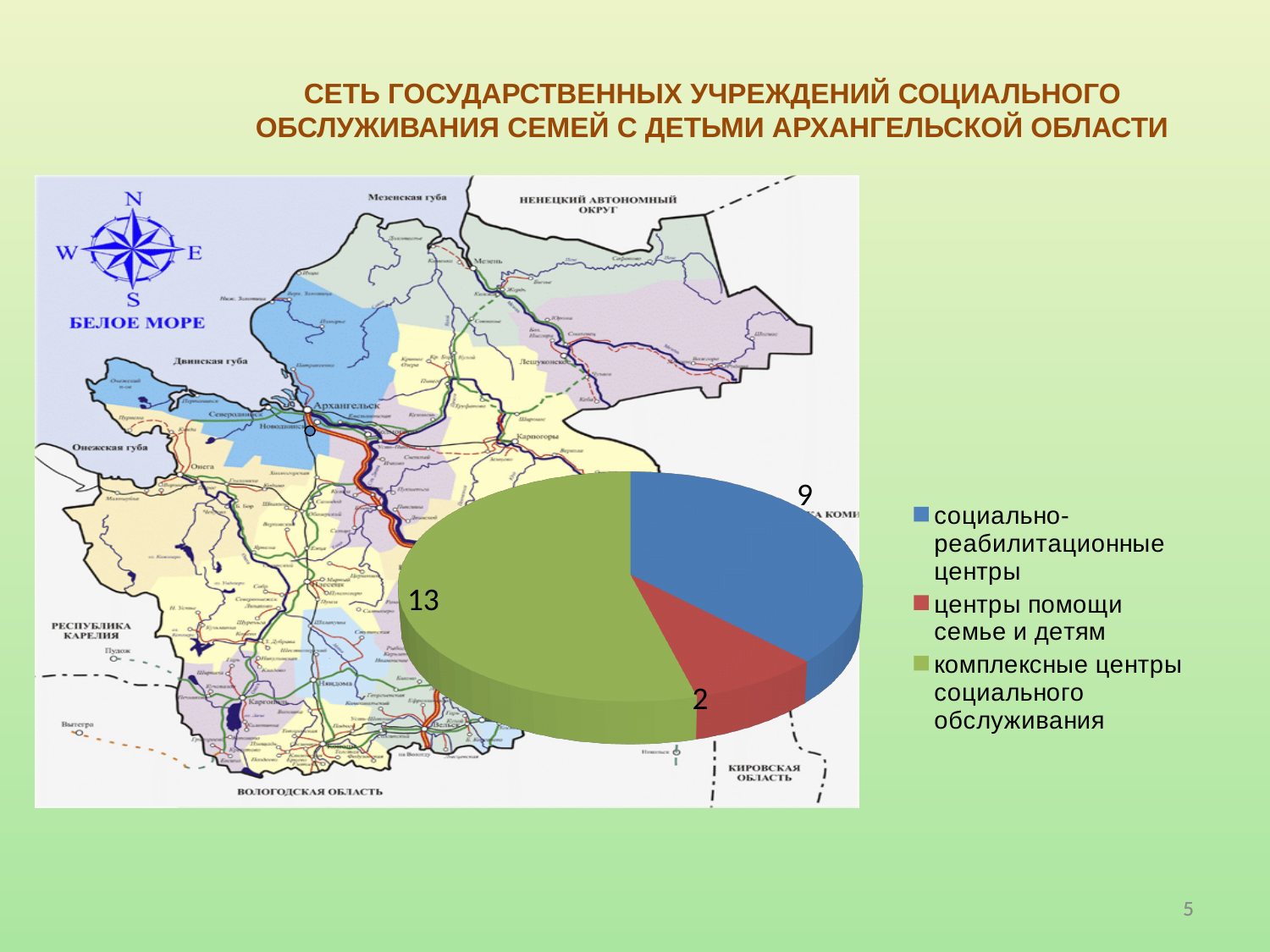
What is the value for центры помощи семье и детям in the pie chart? 2 Which is larger: the value for социально-реабилитационные центры or the value for центры помощи семье и детям? социально-реабилитационные центры What is the value for комплексные центры социального обслуживания in the pie chart? 13 Which category has the largest slice in the pie chart? комплексные центры социального обслуживания What is the value for социально-реабилитационные центры in the pie chart? 9 What is the difference between the values for комплексные центры социального обслуживания and социально-реабилитационные центры? 4 What kind of chart is shown on the slide? pie chart How many entries does the legend of the pie chart list? 3 What colour is the slice for комплексные центры социального обслуживания? green Which category has the smallest slice in the pie chart? центры помощи семье и детям What is the total of all slices in the pie chart? 24 How many slices does the pie chart have? 3